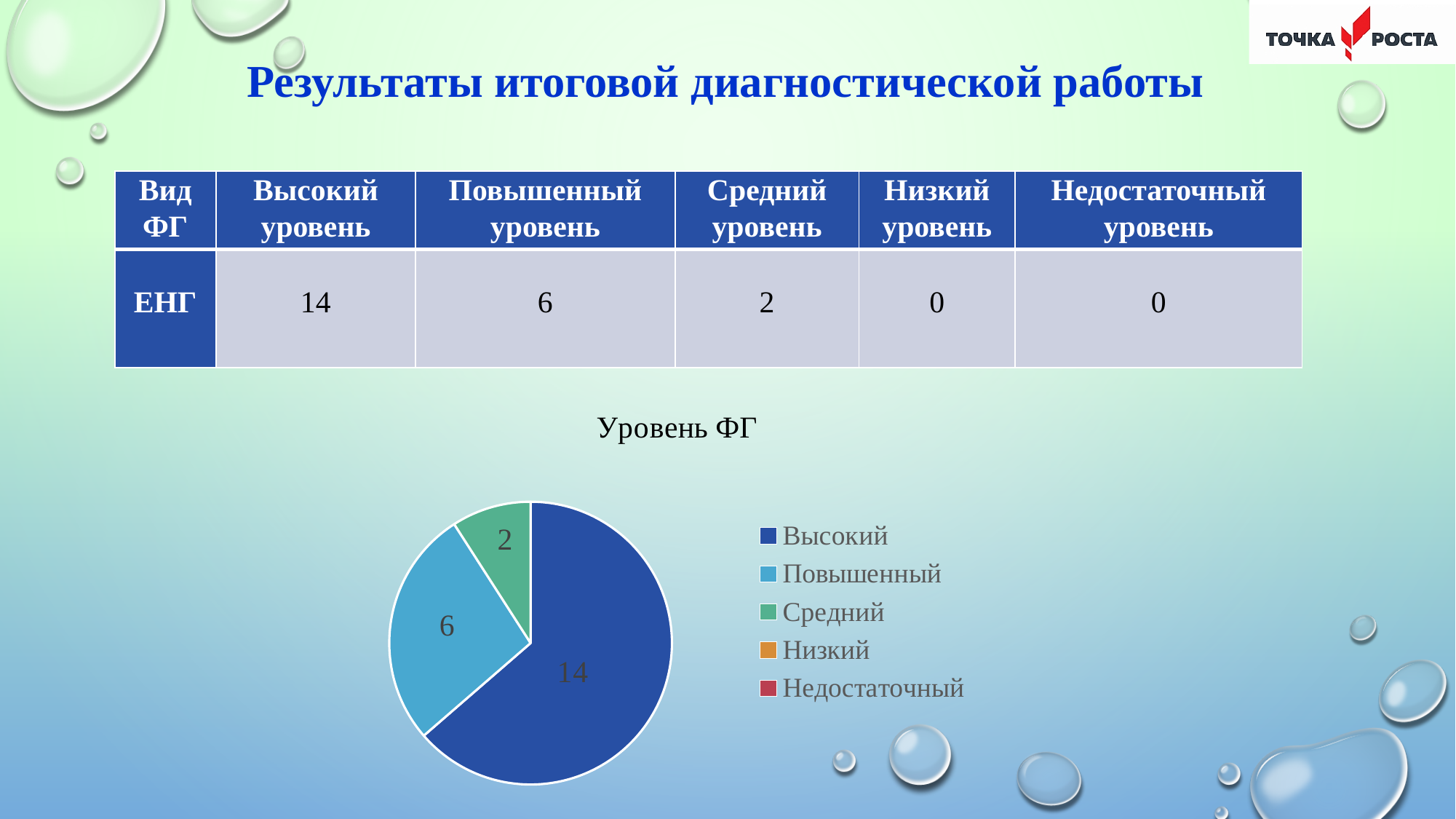
What is the total of the three labelled slices in the pie chart? 22 What is the difference between the Повышенный and Средний values in the pie chart? 4 What value is shown for the Высокий slice of the pie chart? 14 What is the title of the pie chart? Уровень ФГ What value is shown for the Повышенный slice of the pie chart? 6 How many entries does the legend of the pie chart list? 5 What kind of chart is shown on the slide? pie chart What is the difference between the Высокий and Повышенный values in the pie chart? 8 What colour is the Высокий slice in the pie chart? dark blue Which is larger in the pie chart, Повышенный or Средний? Повышенный Which category has the largest slice in the pie chart? Высокий What value is shown for the Средний slice of the pie chart? 2